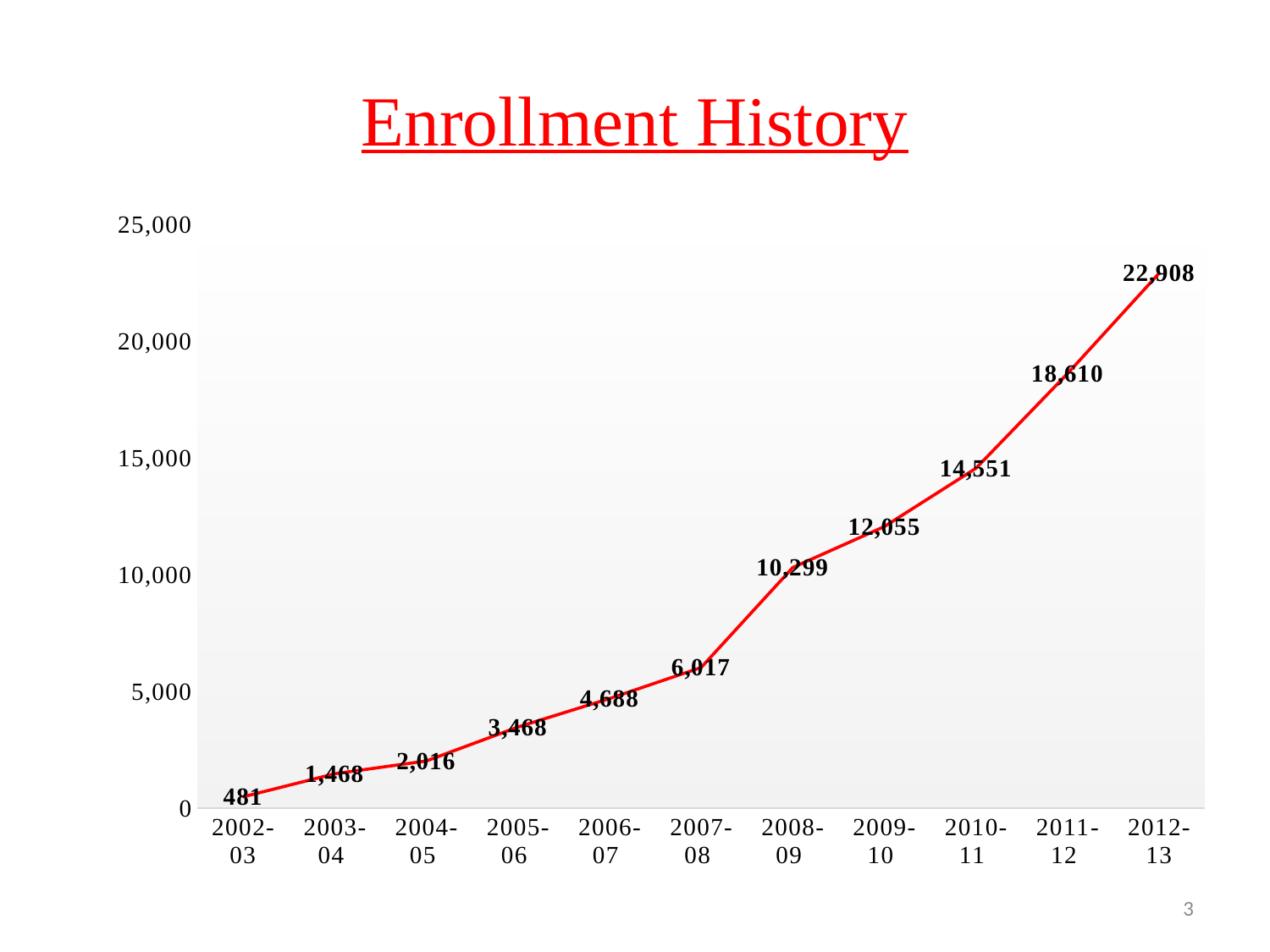
Does enrollment rise or fall from 2002-03 to 2012-13? rise Which year has the lowest enrollment? 2002-03 Is the enrollment value for 2010-11 greater or less than 15,000? less How many years are plotted on the chart? 11 What is the enrollment value for 2008-09? 10,299 What is the enrollment value for 2011-12? 18,610 Which is larger, the enrollment for 2009-10 or for 2010-11? 2010-11 What is the difference in enrollment between 2007-08 and 2006-07? 1,329 Which year has the highest enrollment? 2012-13 What kind of chart is shown on the slide? line chart What is the enrollment value for 2002-03? 481 What is the difference in enrollment between 2012-13 and 2011-12? 4,298